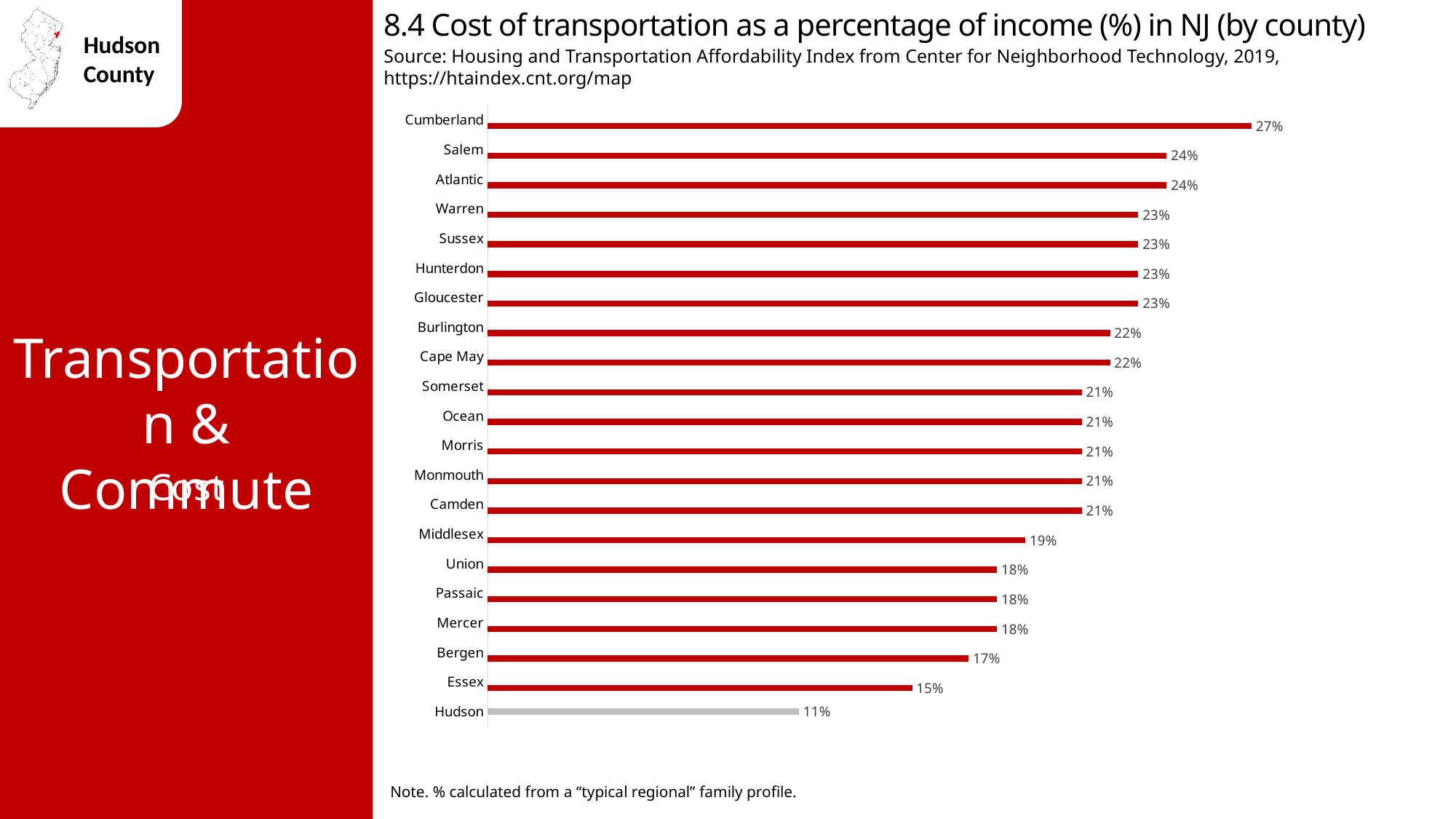
What is the cost of transportation as a percentage of income for Cumberland County? 27% Which county has the lowest cost of transportation as a percentage of income? Hudson What is the value shown for Bergen County? 17% What is the cost of transportation as a percentage of income for Hudson County? 11% How many counties are shown in the chart? 21 What is the difference between the values for Cumberland and Hudson? 16% Which county's bar is shown in gray rather than red? Hudson What type of chart is shown on the slide? Bar chart What is the value shown for Middlesex County? 19% What is the difference between the values for Essex and Hudson? 4% Which county has the highest cost of transportation as a percentage of income? Cumberland Which has a higher value, Salem or Essex? Salem